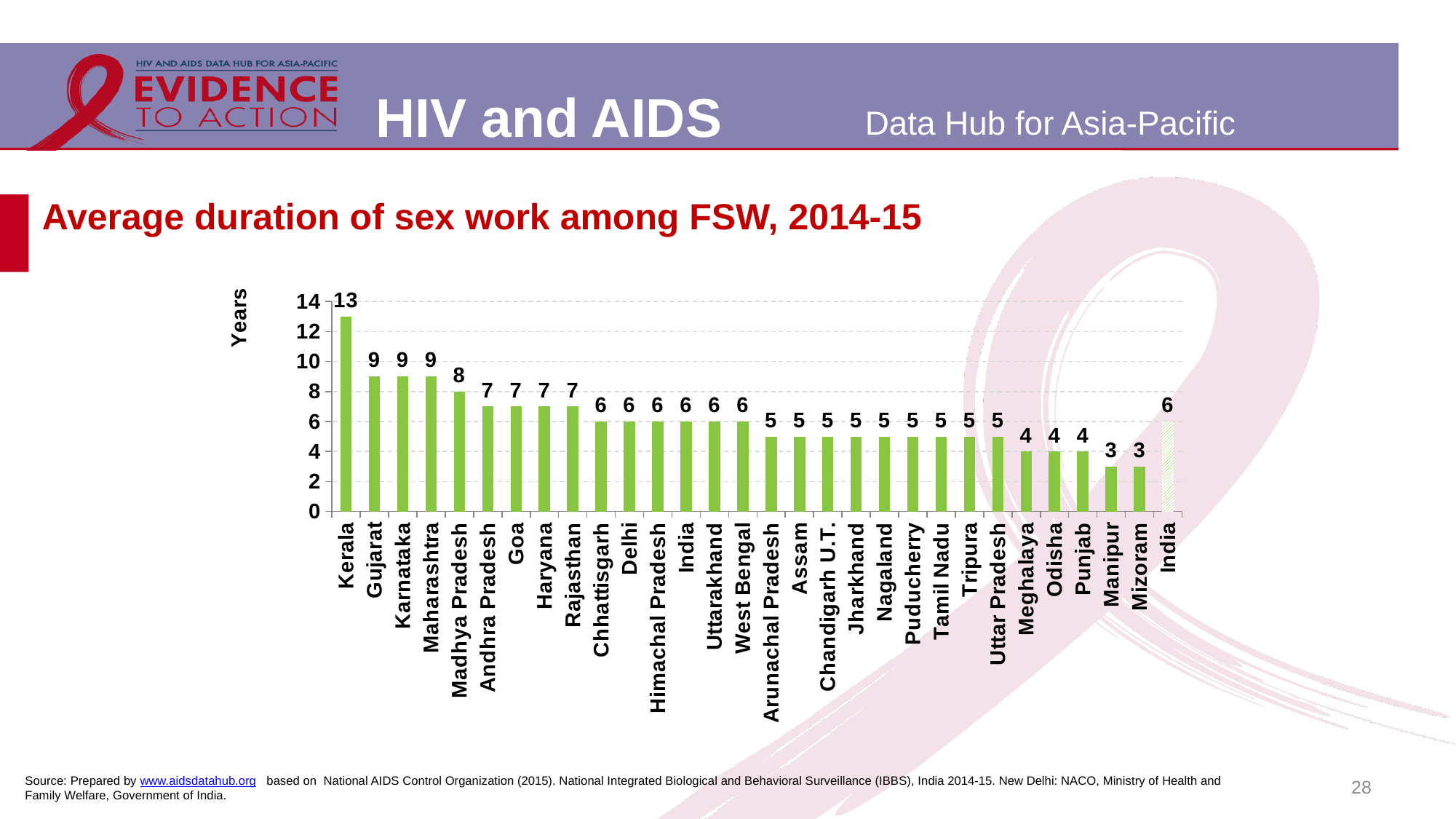
What is the difference between the values for Maharashtra and Punjab? 5 What is the value shown for Tamil Nadu? 5 What is the value shown for Meghalaya? 4 What is the value shown for Madhya Pradesh? 8 What unit is shown on the vertical axis label? Years Which has a larger value, Manipur or Delhi? Delhi Which state has the highest average duration of sex work? Kerala What is the average duration of sex work among FSW in Kerala? 13 What kind of chart is shown on the slide? Bar chart What is the difference between the values for Kerala and Gujarat? 4 How many bars are plotted in the chart? 30 Which has a larger value, Haryana or Odisha? Haryana